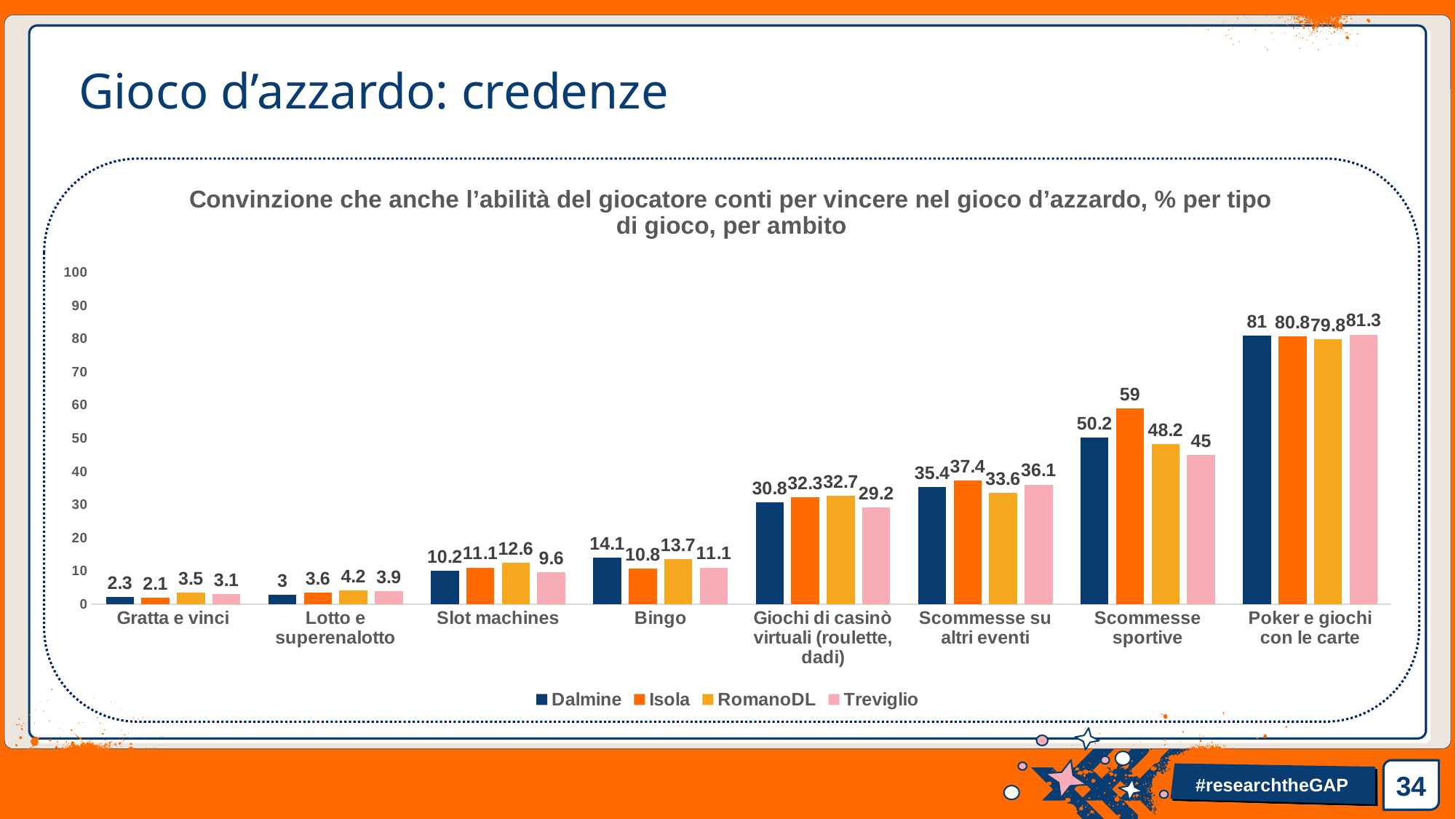
Which category has the highest value for Dalmine? Poker e giochi con le carte How many game categories are shown on the x axis? 8 How many series does the legend list? 4 What is the value for Treviglio in the Giochi di casinò virtuali (roulette, dadi) category? 29.2 What is the value for Dalmine in the Bingo category? 14.1 What is the value for Isola in the Scommesse sportive category? 59 What kind of chart is shown on the slide? Bar chart Which series is shown in pink in the legend? Treviglio What is the difference between the Isola and Treviglio values in the Scommesse sportive category? 14 What is the value for RomanoDL in the Slot machines category? 12.6 In the Bingo category, which is larger: the Dalmine value or the Isola value? Dalmine Which category has the lowest value for Isola? Gratta e vinci